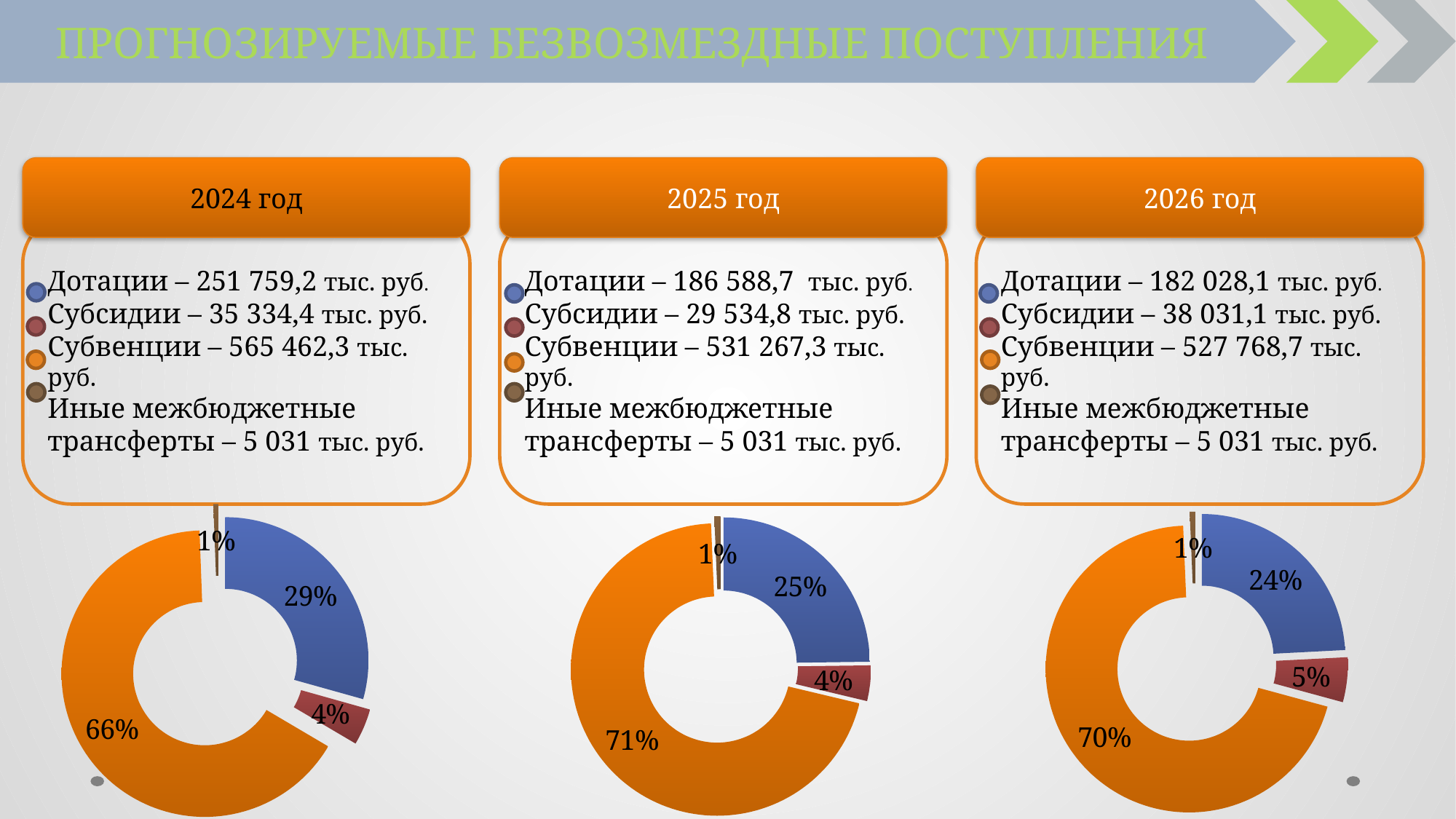
In the 2026 год chart, what share of the doughnut is Субвенции? 70% In the 2025 год chart, which is larger: the share for Дотации or the share for Субсидии? Дотации In the 2026 год chart, which category has the smallest share? Иные межбюджетные трансферты What kind of chart is used for 2026 год? Doughnut chart In the 2024 год chart, what share of the doughnut is Субвенции? 66% In the 2026 год chart, what share of the doughnut is Субсидии? 5% How many categories does the 2025 год chart show? 4 In the 2024 год chart, what colour is the Дотации slice? Blue How many doughnut charts are shown on the slide? 3 In the 2024 год chart, which category has the largest share? Субвенции In the 2024 год chart, what is the difference in percentage points between the Субвенции share and the Дотации share? 37